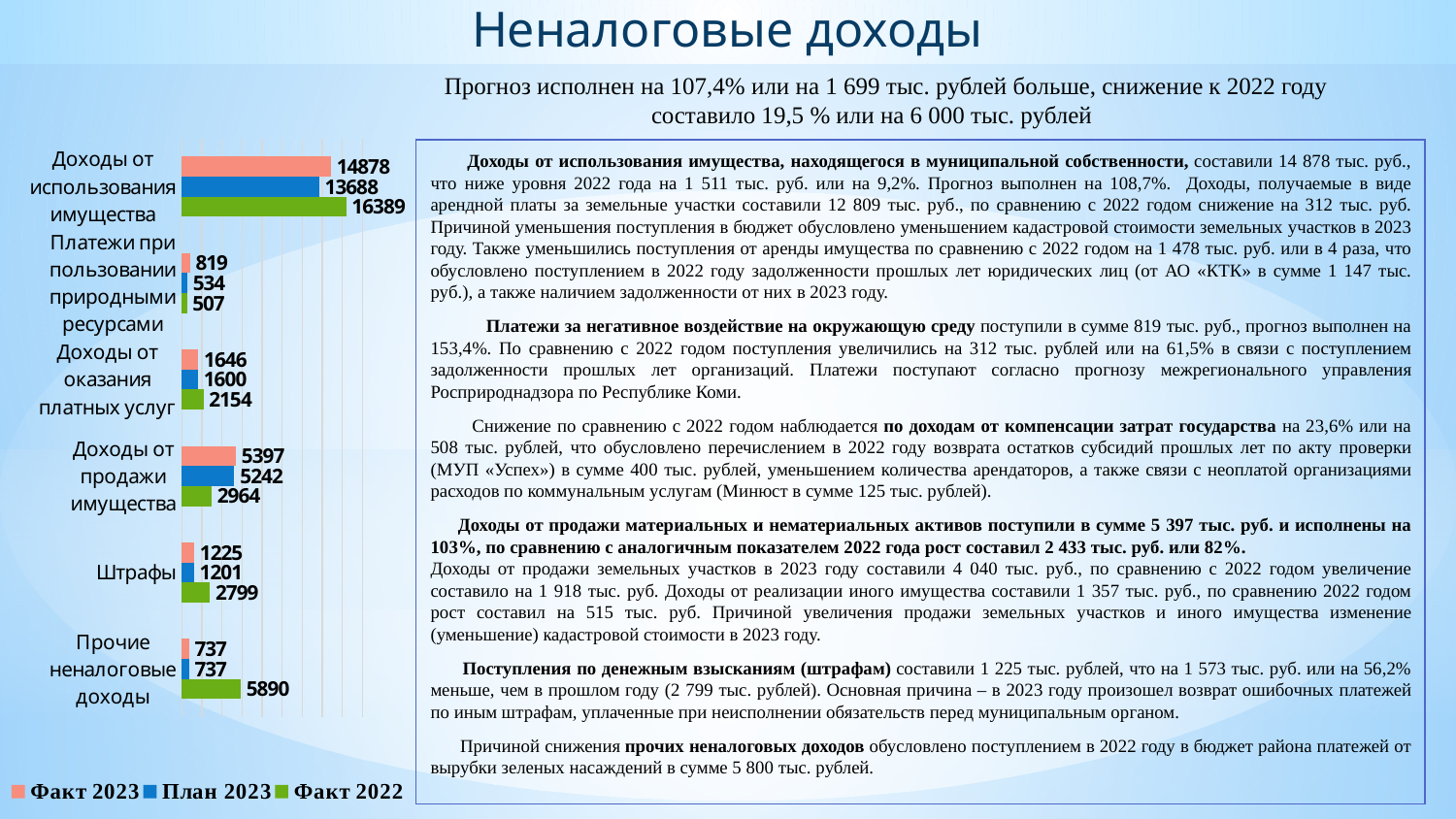
Какое значение показателя «Факт 2022» для категории «Прочие неналоговые доходы»? 5890 В какой категории значение «Факт 2022» наименьшее? Платежи при пользовании природными ресурсами Какое значение показателя «Факт 2023» для категории «Доходы от использования имущества»? 14878 В какой категории значение «Факт 2023» наибольшее? Доходы от использования имущества Сколько категорий показано на диаграмме? 6 Какого типа эта диаграмма? Столбчатая (линейчатая) диаграмма Что больше для категории «Доходы от продажи имущества»: «Факт 2023» или «Факт 2022»? Факт 2023 Что больше для категории «Штрафы»: «Факт 2023» или «Факт 2022»? Факт 2022 Какое значение показателя «План 2023» для категории «Штрафы»? 1201 На сколько значение «Факт 2022» больше значения «Факт 2023» для категории «Доходы от использования имущества»? 1511 Какое значение показателя «Факт 2023» для категории «Платежи при пользовании природными ресурсами»? 819 Сколько рядов данных перечислено в легенде диаграммы? 3